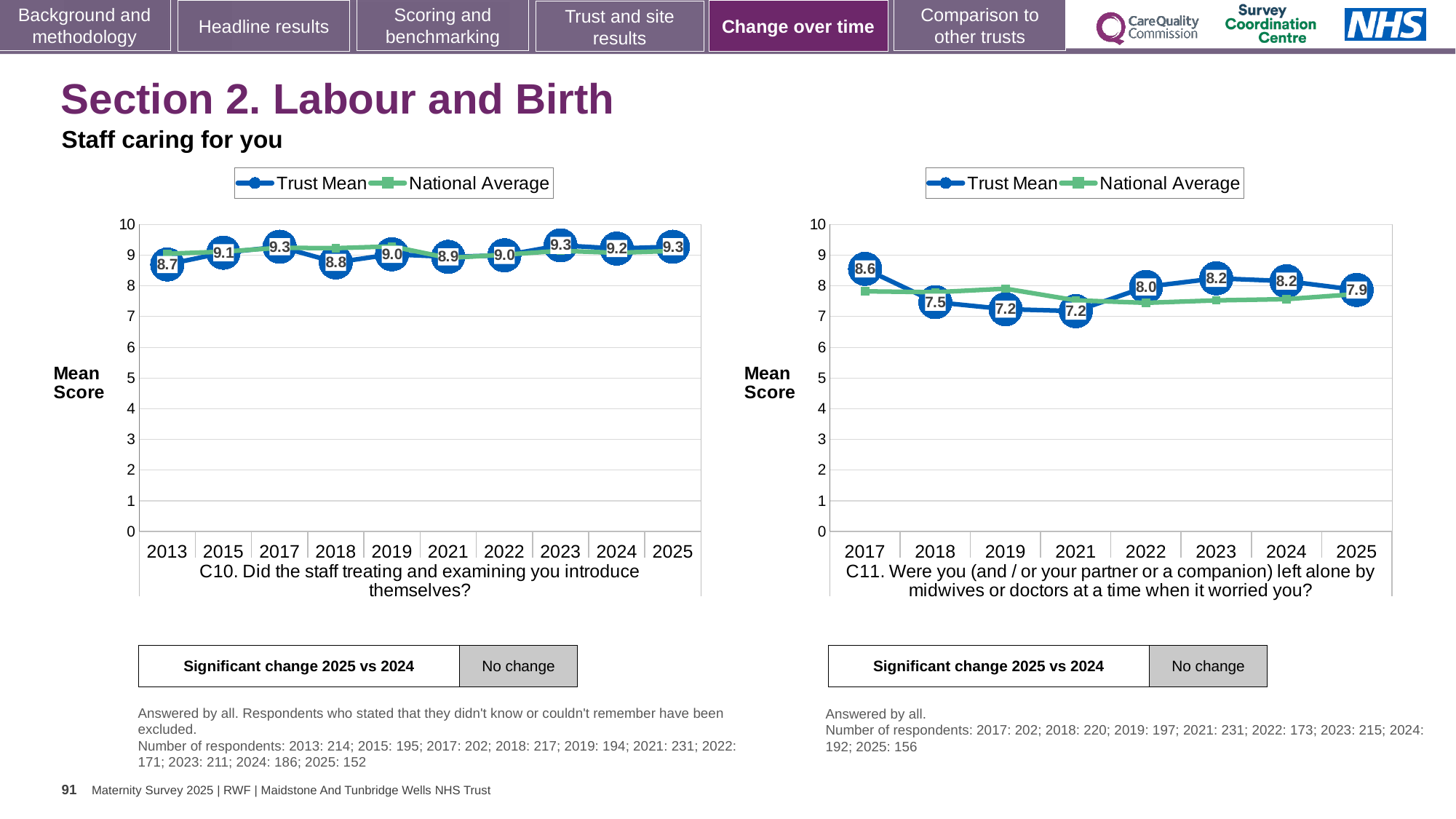
In the C10 chart on the left, what is the Trust Mean score for 2013? 8.7 In the C11 chart on the right, what is the Trust Mean score for 2022? 8.0 In the C10 chart on the left, what is the Trust Mean score for 2025? 9.3 In the C10 chart on the left, what is the difference between the Trust Mean scores for 2025 and 2013? 0.6 In the C10 chart on the left, which year has the lowest Trust Mean score? 2013 In the C11 chart on the right, is the National Average value for 2021 greater or less than 8? less In the C11 chart on the right, what is the difference between the Trust Mean scores for 2017 and 2018? 1.1 In the C11 chart on the right, is the Trust Mean score for 2023 larger or smaller than the score for 2025? larger How many series does the legend of the C11 chart on the right list? 2 How many years are plotted on the x axis of the C10 chart on the left? 10 In the C11 chart on the right, what is the Trust Mean score for 2017? 8.6 In the C11 chart on the right, which year has the highest Trust Mean score? 2017